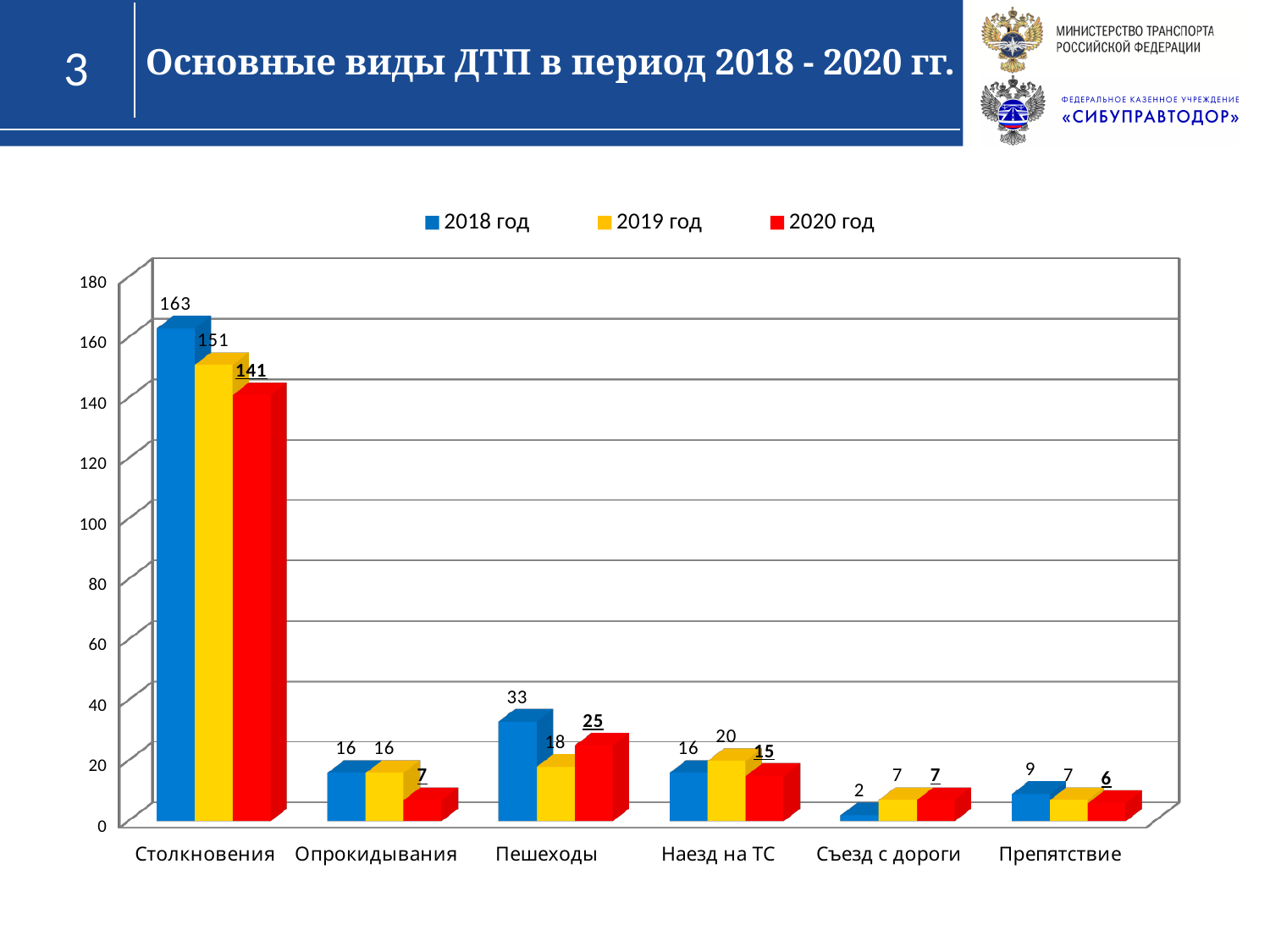
How many categories are shown on the x axis? 6 What colour represents the 2020 год series in the legend? Red What is the value for Столкновения in the 2018 год series? 163 How many series does the legend list? 3 Which category has the highest value in the 2019 год series? Столкновения What is the value for Съезд с дороги in the 2018 год series? 2 What is the difference between the 2018 год and 2020 год values for Столкновения? 22 What is the value for Пешеходы in the 2020 год series? 25 Which category has the lowest value in the 2018 год series? Съезд с дороги Which is larger for Наезд на ТС: the 2019 год value or the 2020 год value? 2019 год Do the values for Столкновения rise or fall from 2018 год to 2020 год? Fall What kind of chart is shown on the slide? Bar chart